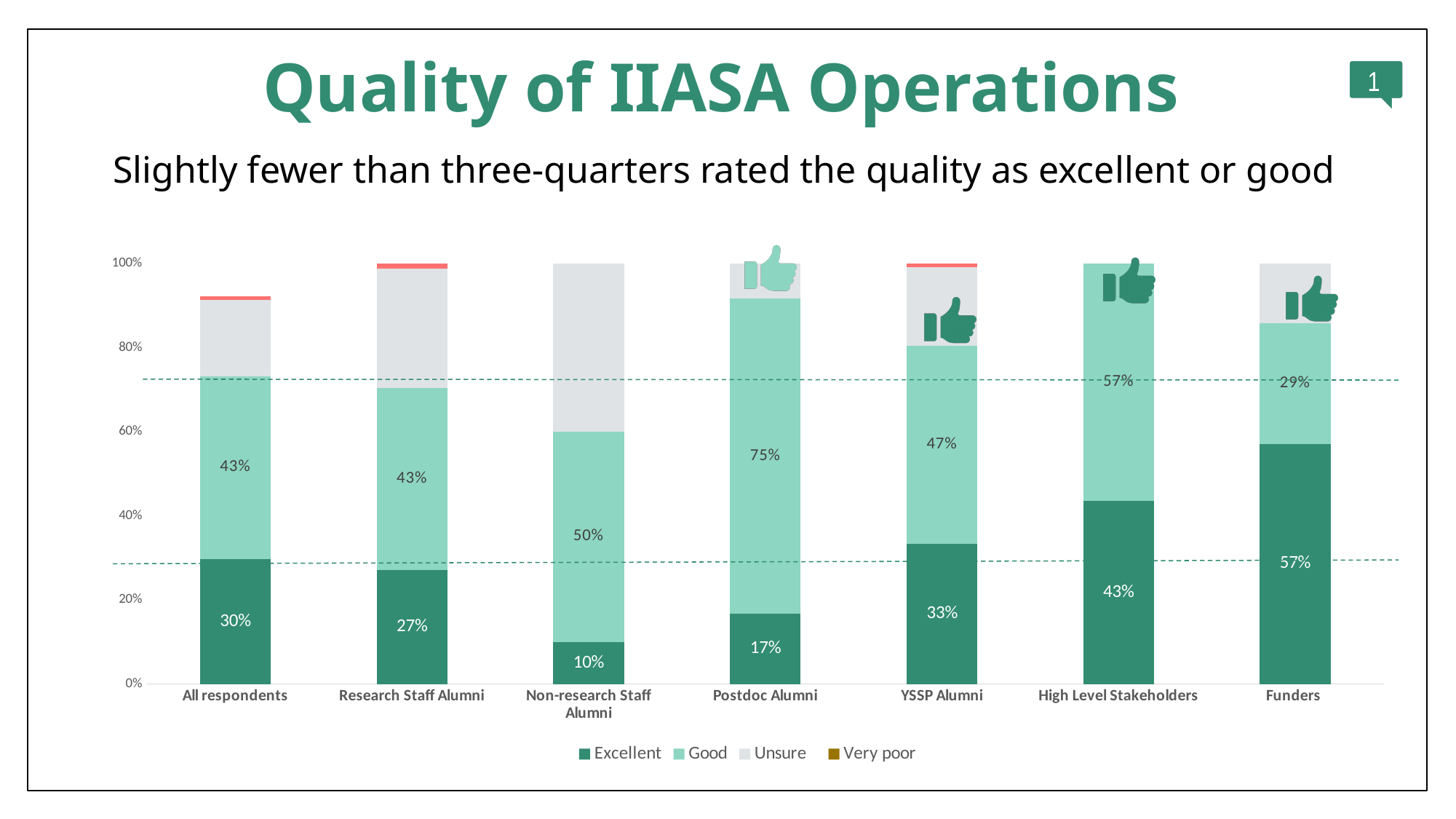
What percentage of Funders rated the quality as Excellent? 57% Which respondent group has the highest Good percentage? Postdoc Alumni Which respondent group has the lowest Excellent percentage? Non-research Staff Alumni What percentage of Postdoc Alumni rated the quality as Good? 75% What kind of chart is shown on the slide? Stacked bar chart What is the combined Excellent and Good percentage for All respondents? 73% How many series does the legend list? 4 How many respondent groups are shown on the x axis? 7 What is the Excellent value for Non-research Staff Alumni? 10% How many percentage points higher is the Excellent value for Funders than for All respondents? 27 percentage points Which group has a larger Good percentage, High Level Stakeholders or YSSP Alumni? High Level Stakeholders Which respondent group has the highest Excellent percentage? Funders